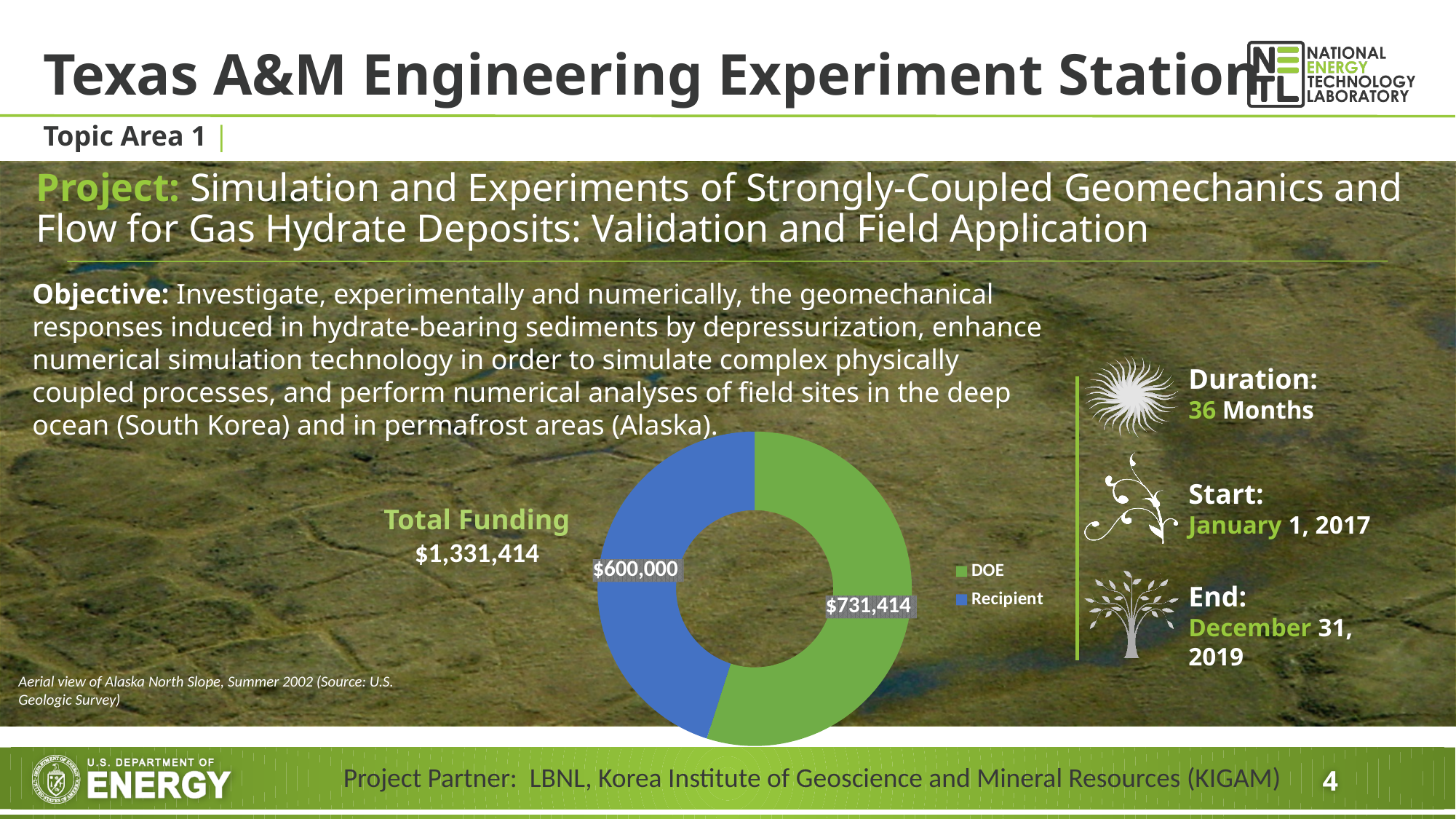
What is the total of the two values shown in the funding chart? $1,331,414 Is the DOE value or the Recipient value larger in the funding chart? DOE What is the difference between the DOE and Recipient values in the funding chart? $131,414 How many categories does the funding chart show? 2 Which category has the smaller share of the funding chart? Recipient How many entries does the legend of the funding chart list? 2 What colour represents Recipient in the funding chart? Blue Which category has the larger share of the funding chart? DOE What colour represents DOE in the funding chart? Green What is the value for Recipient in the funding chart? $600,000 What kind of chart is used to show the funding split? Donut (pie) chart What is the value for DOE in the funding chart? $731,414